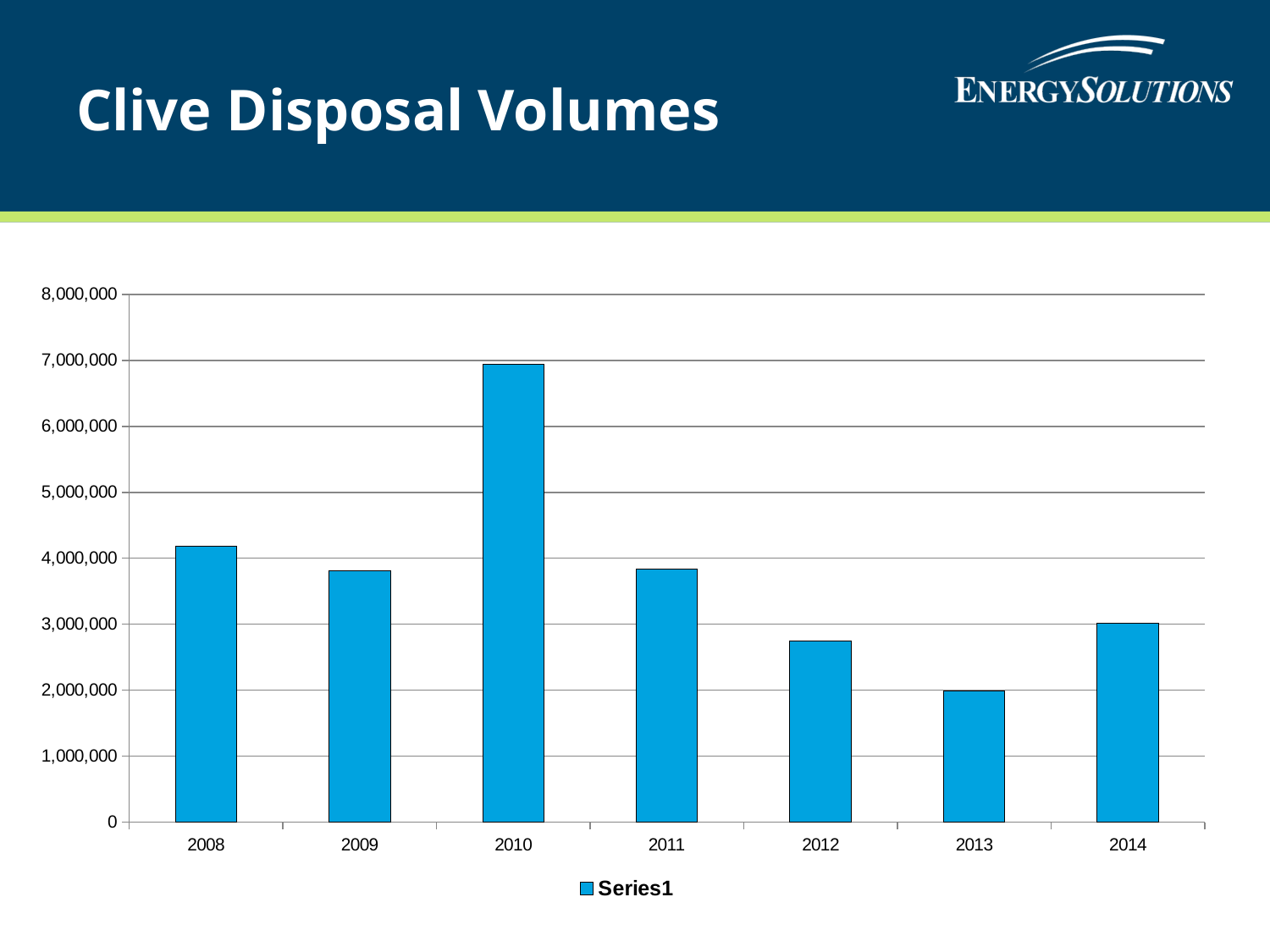
Which year has the larger value, 2008 or 2009? 2008 What is the name of the series shown in the legend? Series1 Which year has the larger value, 2011 or 2012? 2011 Is the value for 2009 greater or less than 4,000,000? less How many years are shown on the x axis of the chart? 7 Which year has the highest disposal volume? 2010 How many series does the legend list? 1 Do the values rise or fall from 2010 to 2013? fall Is the value for 2012 greater or less than 3,000,000? less Which year has the lowest disposal volume? 2013 Is the value for 2010 greater or less than 6,000,000? greater What kind of chart is shown on the slide? bar chart